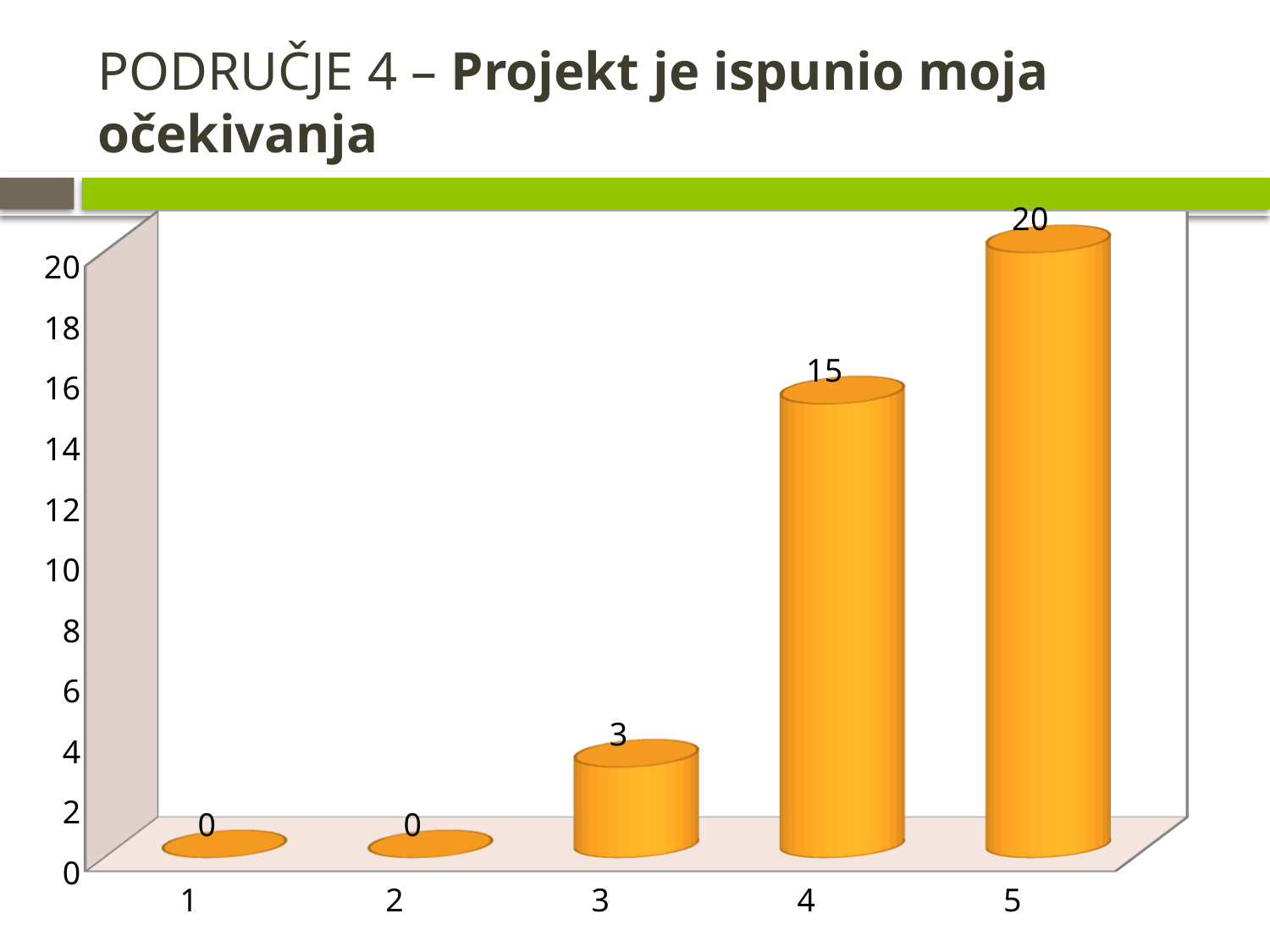
Which is larger, the value for category 3 or the value for category 4? 4 How many categories are shown on the x axis? 5 What is the total of all the values shown in the chart? 38 What is the value for category 5? 20 What kind of chart is shown on the slide? bar chart What is the value for category 1? 0 Do the values rise or fall from category 1 to category 5? rise What is the difference between the values for categories 5 and 4? 5 Which category has the highest value? 5 What is the value for category 4? 15 What is the difference between the values for categories 4 and 3? 12 What is the value for category 3? 3